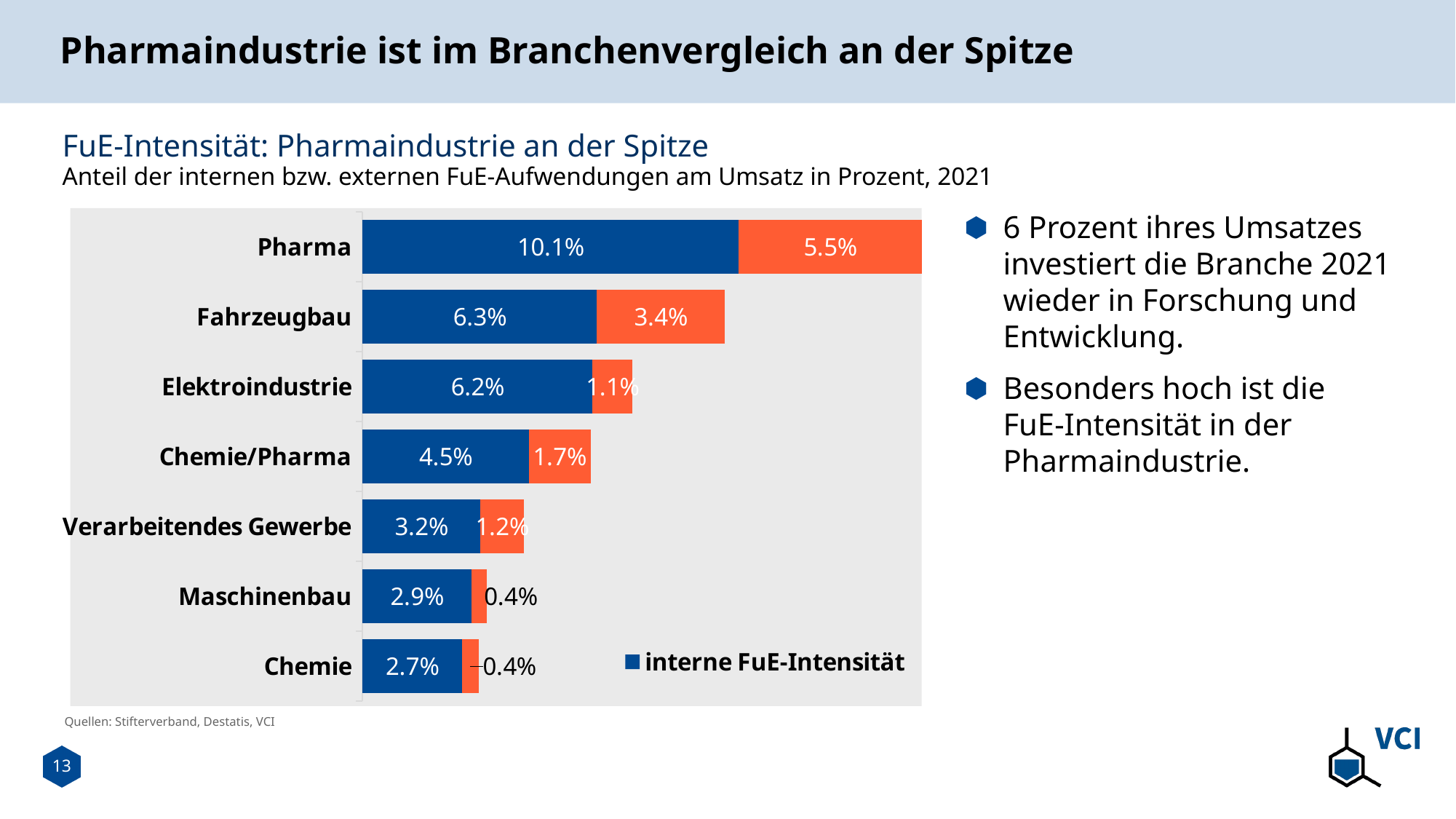
What is the interne FuE-Intensität value for Pharma? 10.1% Which category has the highest interne FuE-Intensität? Pharma Which has a larger interne FuE-Intensität, Chemie/Pharma or Verarbeitendes Gewerbe? Chemie/Pharma Which category has the lowest interne FuE-Intensität? Chemie What value is shown on the orange segment of the Chemie/Pharma bar? 1.7% What is the difference between the interne FuE-Intensität of Pharma and Fahrzeugbau? 3.8% What is the total of the two segments of the Pharma bar? 15.6% What kind of chart is shown on the slide? Stacked bar chart How many categories are shown in the chart? 7 What is the title of the chart? FuE-Intensität: Pharmaindustrie an der Spitze What is the interne FuE-Intensität value for Elektroindustrie? 6.2% What value is shown on the orange segment of the Fahrzeugbau bar? 3.4%